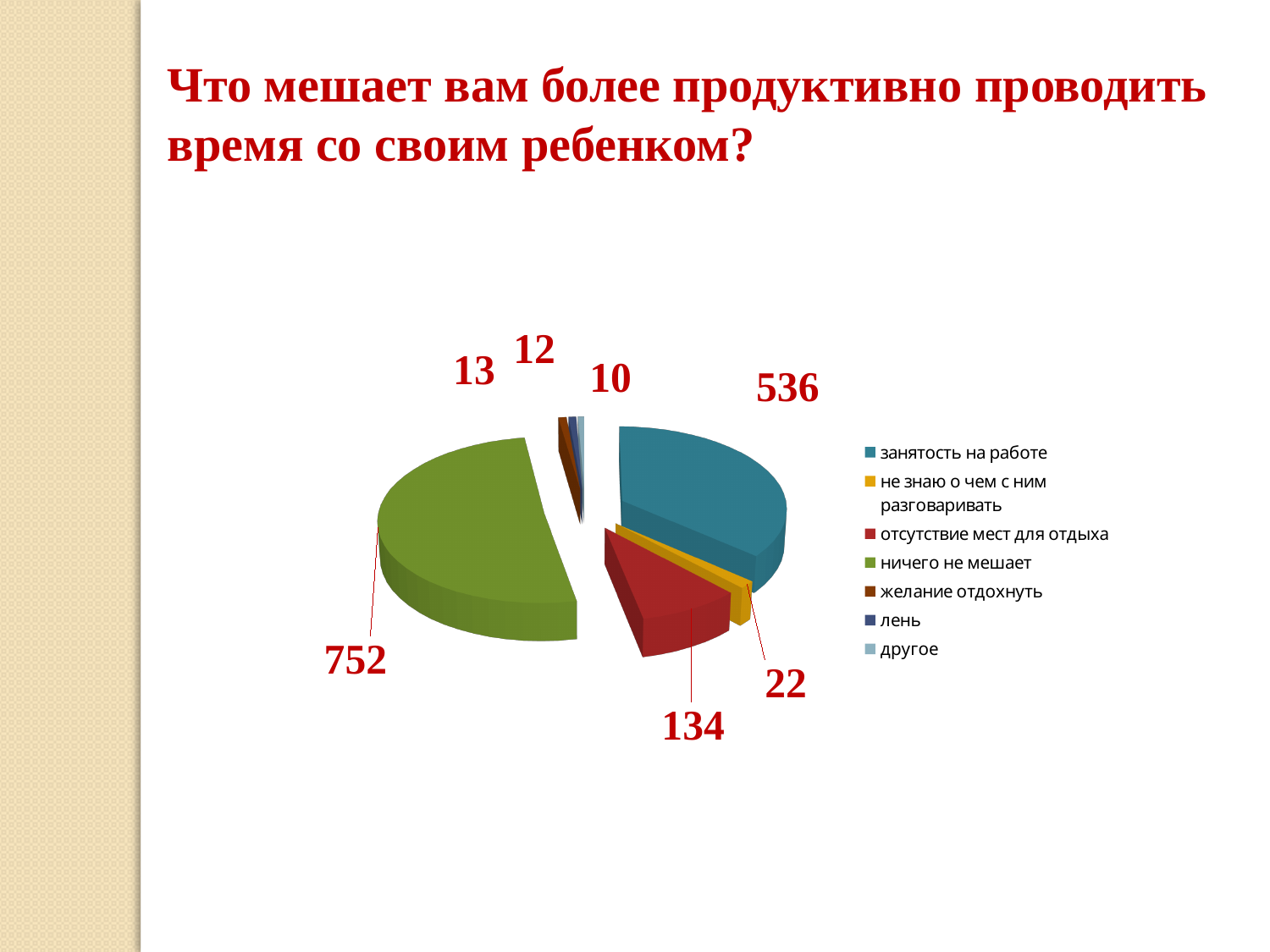
Which category has the smallest slice in the pie chart? другое What value is shown for the slice "не знаю о чем с ним разговаривать"? 22 What kind of chart is shown on the slide? pie chart Which category has the largest slice in the pie chart? ничего не мешает What colour is the slice for "желание отдохнуть"? brown What value is shown for the slice "отсутствие мест для отдыха"? 134 What value is shown for the slice "занятость на работе"? 536 What is the difference between the values for "ничего не мешает" and "занятость на работе"? 216 What value is shown for the slice "лень"? 12 What value is shown for the slice "ничего не мешает"? 752 Which is larger: the value for "отсутствие мест для отдыха" or the value for "не знаю о чем с ним разговаривать"? отсутствие мест для отдыха How many categories does the legend of the pie chart list? 7